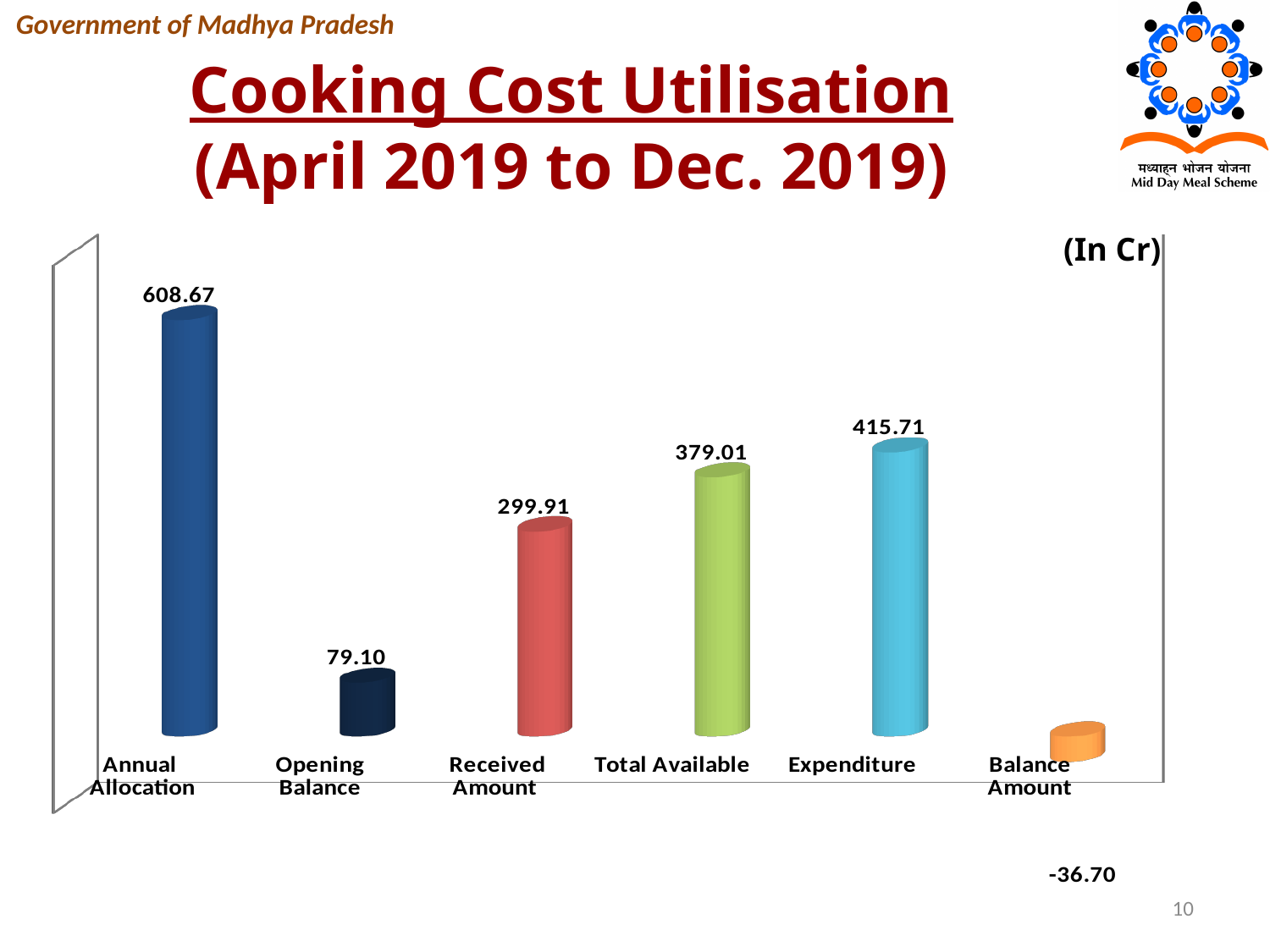
What is the value for Received Amount? 299.91 Which is larger, Received Amount or Expenditure? Expenditure What is the value for Opening Balance? 79.10 What is the value for Annual Allocation? 608.67 What is the difference between Expenditure and Total Available? 36.70 Which category has the lowest value? Balance Amount What is the value for Total Available? 379.01 Which category has the highest value? Annual Allocation How many categories are shown in the chart? 6 What unit is stated for the values in the chart? In Cr What is the value for Expenditure? 415.71 What is the value for Balance Amount? -36.70